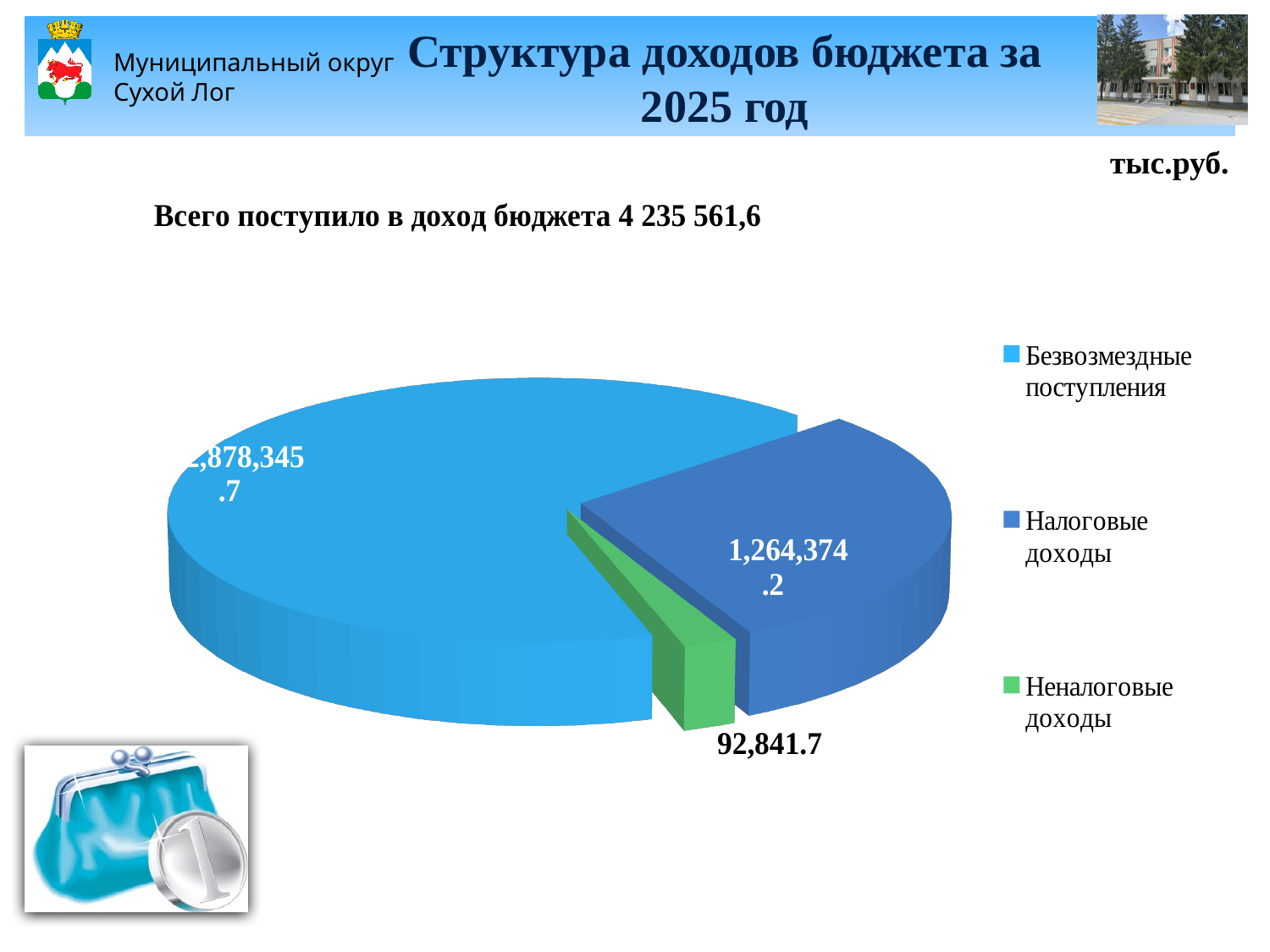
What kind of chart is shown on the slide? pie chart What colour is the slice for Неналоговые доходы? green What is the difference between the values for Налоговые доходы and Неналоговые доходы? 1,171,532.5 Which category has the largest slice of the pie? Безвозмездные поступления Which category has the smallest slice of the pie? Неналоговые доходы How many slices does the pie chart have? 3 What is the title of the chart on the slide? Всего поступило в доход бюджета 4 235 561,6 What is the value shown for Неналоговые доходы? 92,841.7 Which is larger, Налоговые доходы or Неналоговые доходы? Налоговые доходы How many entries does the legend list? 3 What is the value shown for Налоговые доходы? 1,264,374.2 What total budget income is stated on the slide? 4 235 561,6